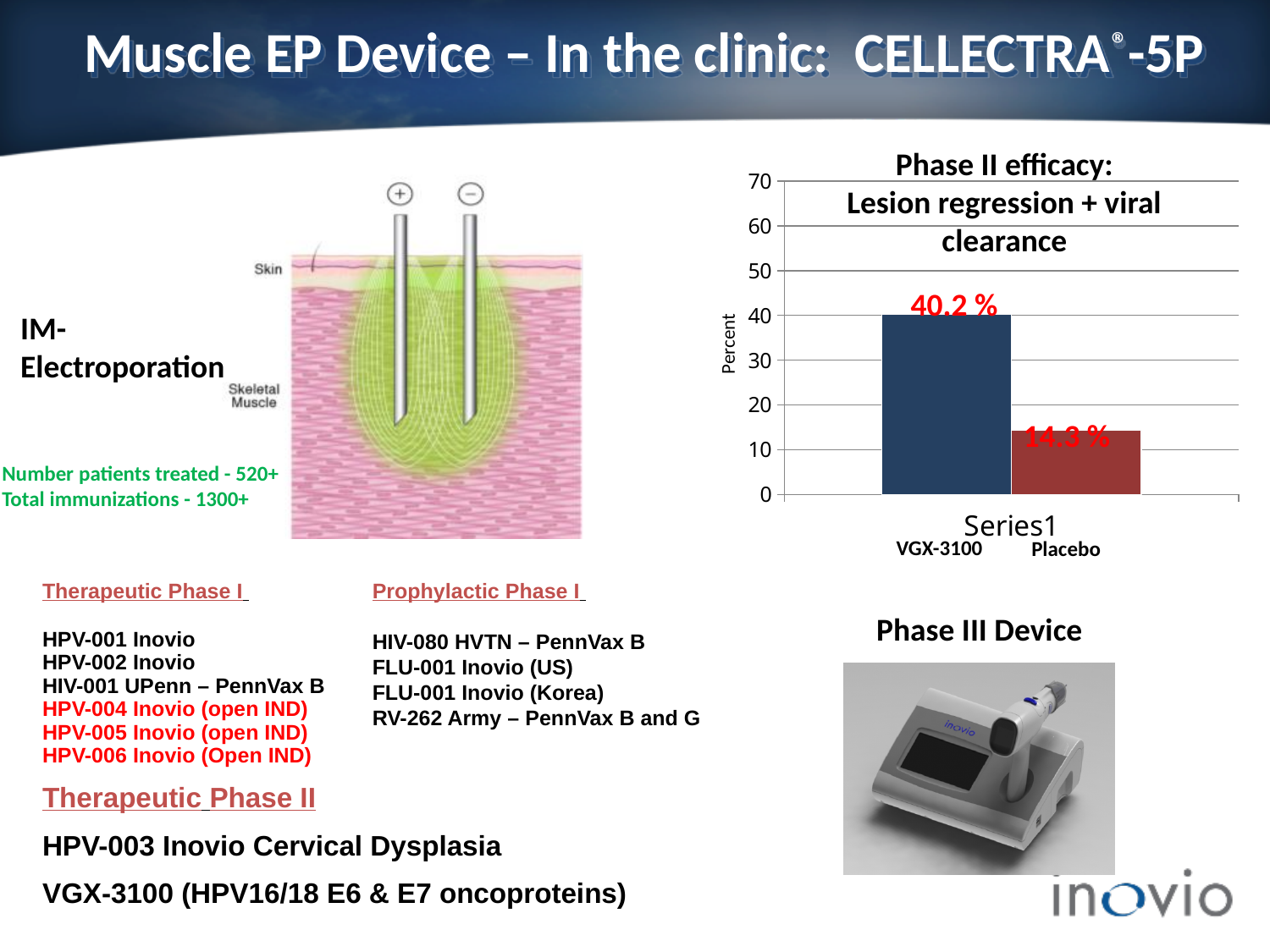
What is the difference between the VGX-3100 and Placebo values in the Phase II efficacy chart? 25.9 % What type of chart is used to show the Phase II efficacy data? bar chart Which bar is lowest in the Phase II efficacy chart? Placebo What is the highest tick value shown on the vertical axis of the Phase II efficacy chart? 70 Is the value for Placebo in the Phase II efficacy chart larger or smaller than the value for VGX-3100? smaller Which bar is higher in the Phase II efficacy chart, VGX-3100 or Placebo? VGX-3100 What is the label on the vertical axis of the Phase II efficacy chart? Percent Is the value for VGX-3100 in the Phase II efficacy chart greater or less than 30? greater Is the value for Placebo in the Phase II efficacy chart greater or less than 20? less How many bars are plotted in the Phase II efficacy chart? 2 What value is shown for VGX-3100 in the Phase II efficacy chart? 40.2 % What value is shown for Placebo in the Phase II efficacy chart? 14.3 %